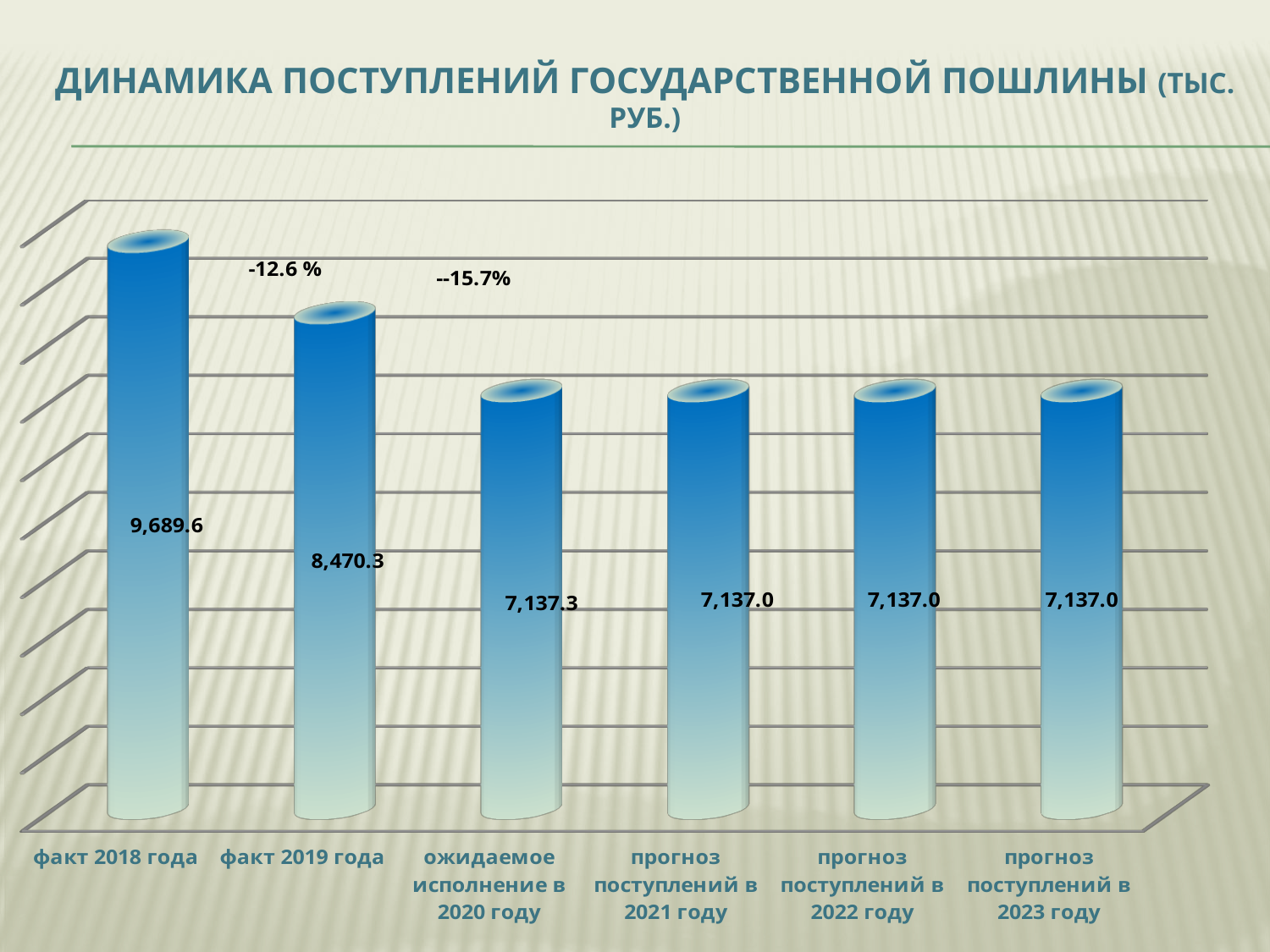
What is the value for прогноз поступлений в 2023 году? 7,137.0 What percentage change is annotated above the bar for факт 2019 года? -12.6 % What is the value for факт 2018 года? 9,689.6 What is the value for ожидаемое исполнение в 2020 году? 7,137.3 Which is larger, the value for факт 2019 года or the value for прогноз поступлений в 2021 году? факт 2019 года What is the difference between the values for факт 2018 года and факт 2019 года? 1,219.3 What is the difference between the values for факт 2019 года and ожидаемое исполнение в 2020 году? 1,333.0 Do the values rise or fall from факт 2018 года to ожидаемое исполнение в 2020 году? fall What kind of chart is shown on the slide? bar chart Which category has the highest value? факт 2018 года What is the value for факт 2019 года? 8,470.3 How many categories are shown on the chart? 6